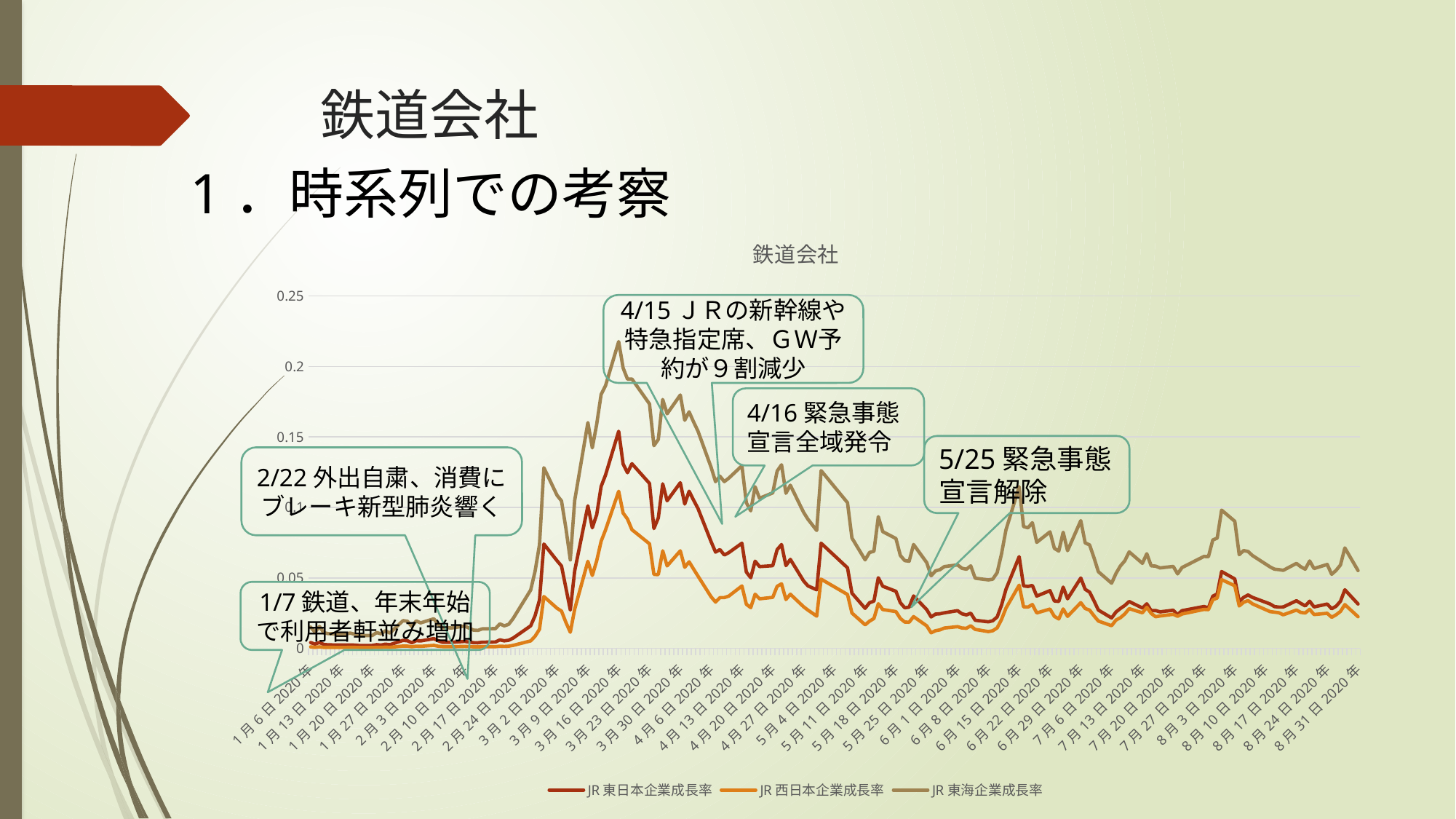
How many series does the chart legend list? 3 Which series reaches the highest peak value on the chart? JR 東海企業成長率 Is the peak value of JR 東海企業成長率 greater or less than 0.15? greater Between 3月16日 and 5月25日 2020年, do the values of JR 東海企業成長率 generally rise or fall? fall What is the title of the chart? 鉄道会社 Is the peak value of JR 西日本企業成長率 greater or less than 0.15? less Which series is drawn in orange according to the legend? JR 西日本企業成長率 Around 3月16日 2020年, which series has the higher value, JR 東海企業成長率 or JR 西日本企業成長率? JR 東海企業成長率 Which series stays lowest across most of the chart? JR 西日本企業成長率 What kind of chart is shown on the slide? line chart Is the peak value of JR 東日本企業成長率 greater or less than 0.1? greater